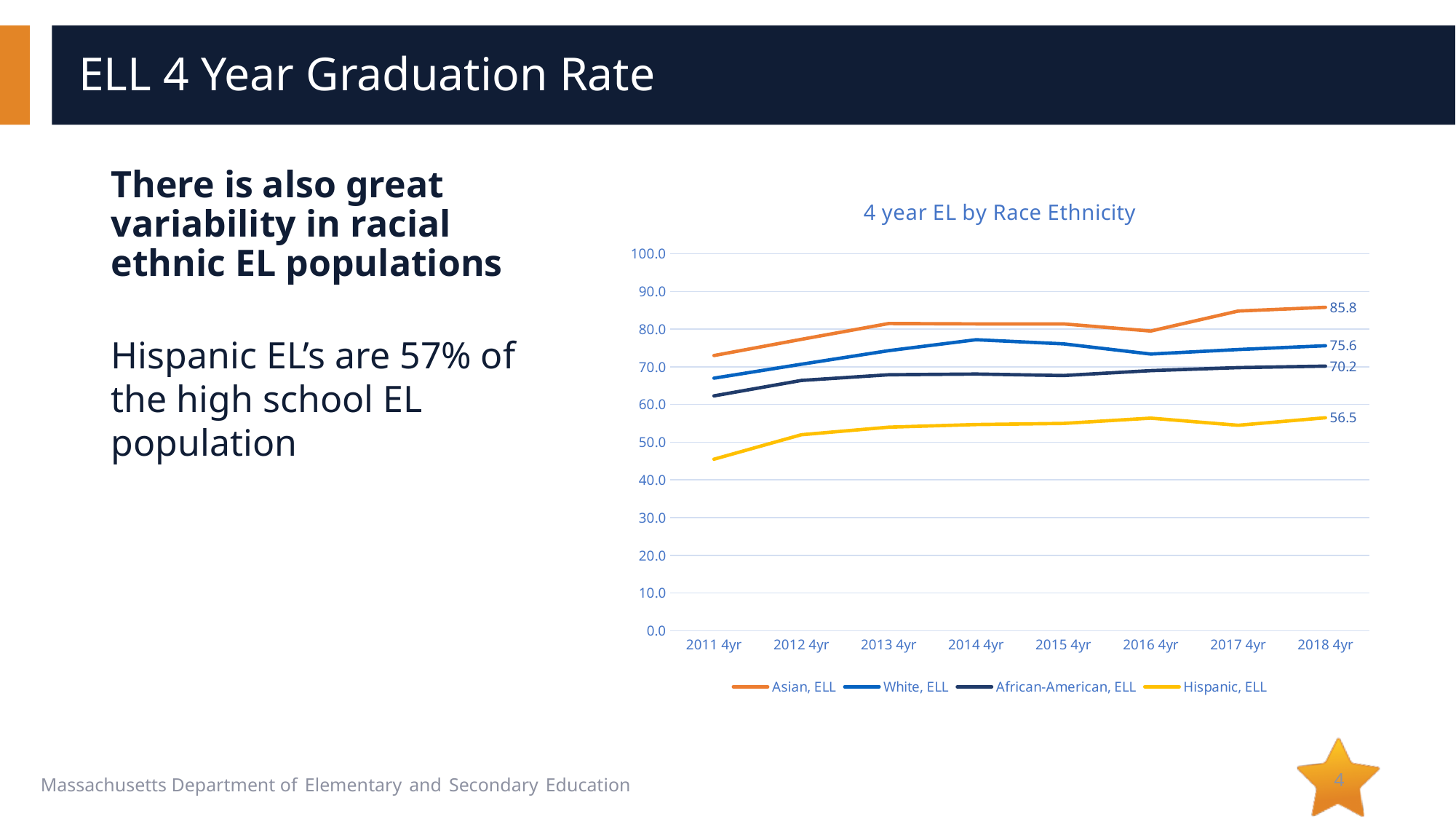
What is the value for Asian, ELL in 2018 4yr? 85.8 What kind of chart is shown on the slide? line chart What is the difference between the Asian, ELL and Hispanic, ELL values in 2018 4yr? 29.3 How many series does the legend list? 4 Which series has the lowest value in 2018 4yr? Hispanic, ELL Is the value for Hispanic, ELL in 2011 4yr greater or less than 50.0? less Which series has the highest value in 2018 4yr? Asian, ELL What is the value for Hispanic, ELL in 2018 4yr? 56.5 What is the value for White, ELL in 2018 4yr? 75.6 What is the value for African-American, ELL in 2018 4yr? 70.2 How many points are on the x axis of the chart? 8 What is the title of the chart? 4 year EL by Race Ethnicity